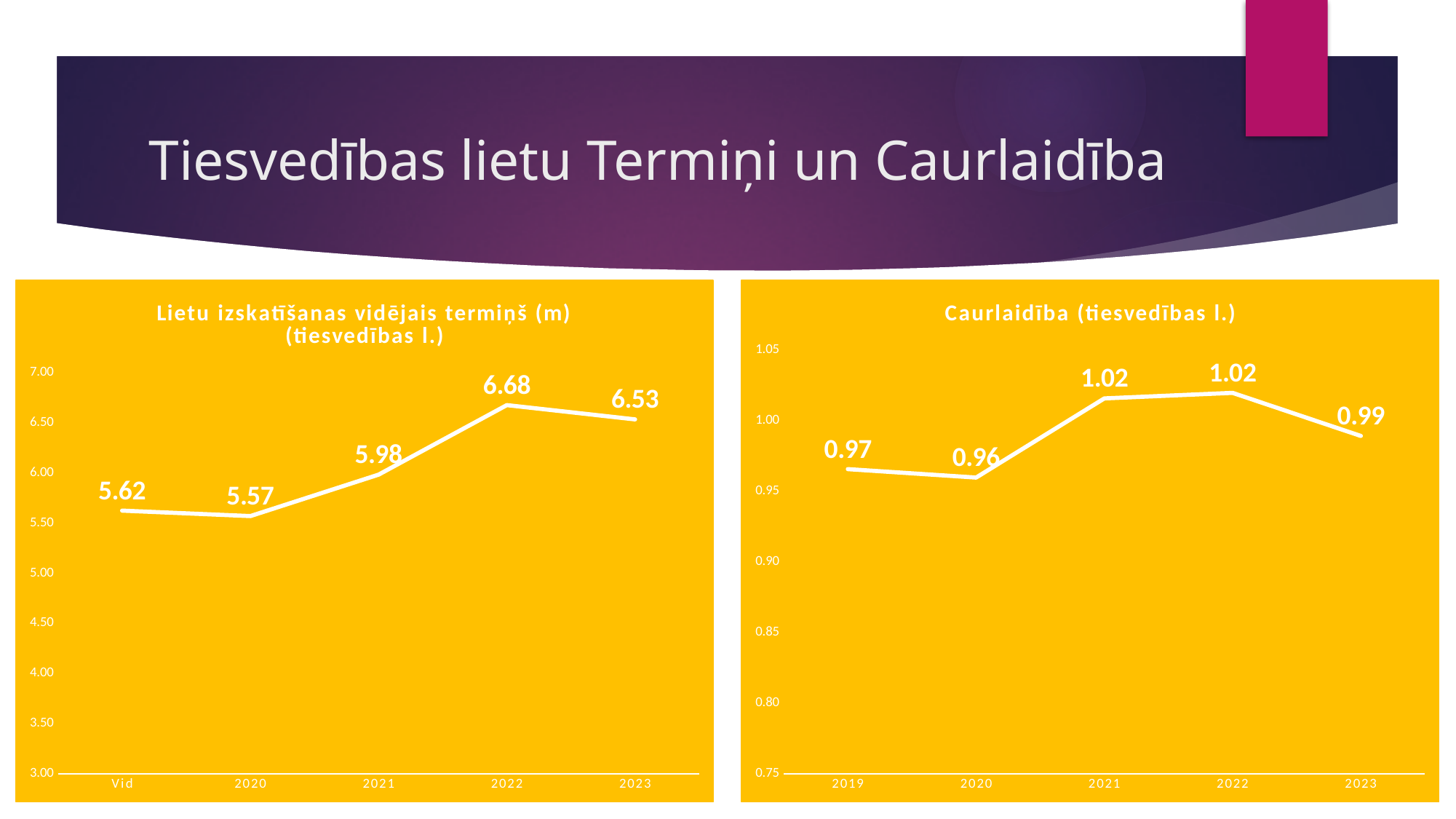
In the left chart 'Lietu izskatīšanas vidējais termiņš (m) (tiesvedības l.)', which category has the lowest value? 2020 In the right chart 'Caurlaidība (tiesvedības l.)', what is the value for 2020? 0.96 In the right chart 'Caurlaidība (tiesvedības l.)', what is the value for 2023? 0.99 In the left chart 'Lietu izskatīšanas vidējais termiņš (m) (tiesvedības l.)', what is the difference between the values for 2022 and 2021? 0.70 In the right chart 'Caurlaidība (tiesvedības l.)', which year has the lowest value? 2020 In the left chart 'Lietu izskatīšanas vidējais termiņš (m) (tiesvedības l.)', what is the value for 'Vid'? 5.62 In the left chart 'Lietu izskatīšanas vidējais termiņš (m) (tiesvedības l.)', how many data points are plotted? 5 In the left chart 'Lietu izskatīšanas vidējais termiņš (m) (tiesvedības l.)', what is the value for 2022? 6.68 What type of chart is the right chart 'Caurlaidība (tiesvedības l.)'? line chart In the right chart 'Caurlaidība (tiesvedības l.)', what is the difference between the values for 2021 and 2020? 0.06 In the right chart 'Caurlaidība (tiesvedības l.)', is the value for 2021 larger or smaller than the value for 2019? larger In the left chart 'Lietu izskatīšanas vidējais termiņš (m) (tiesvedības l.)', which category has the highest value? 2022